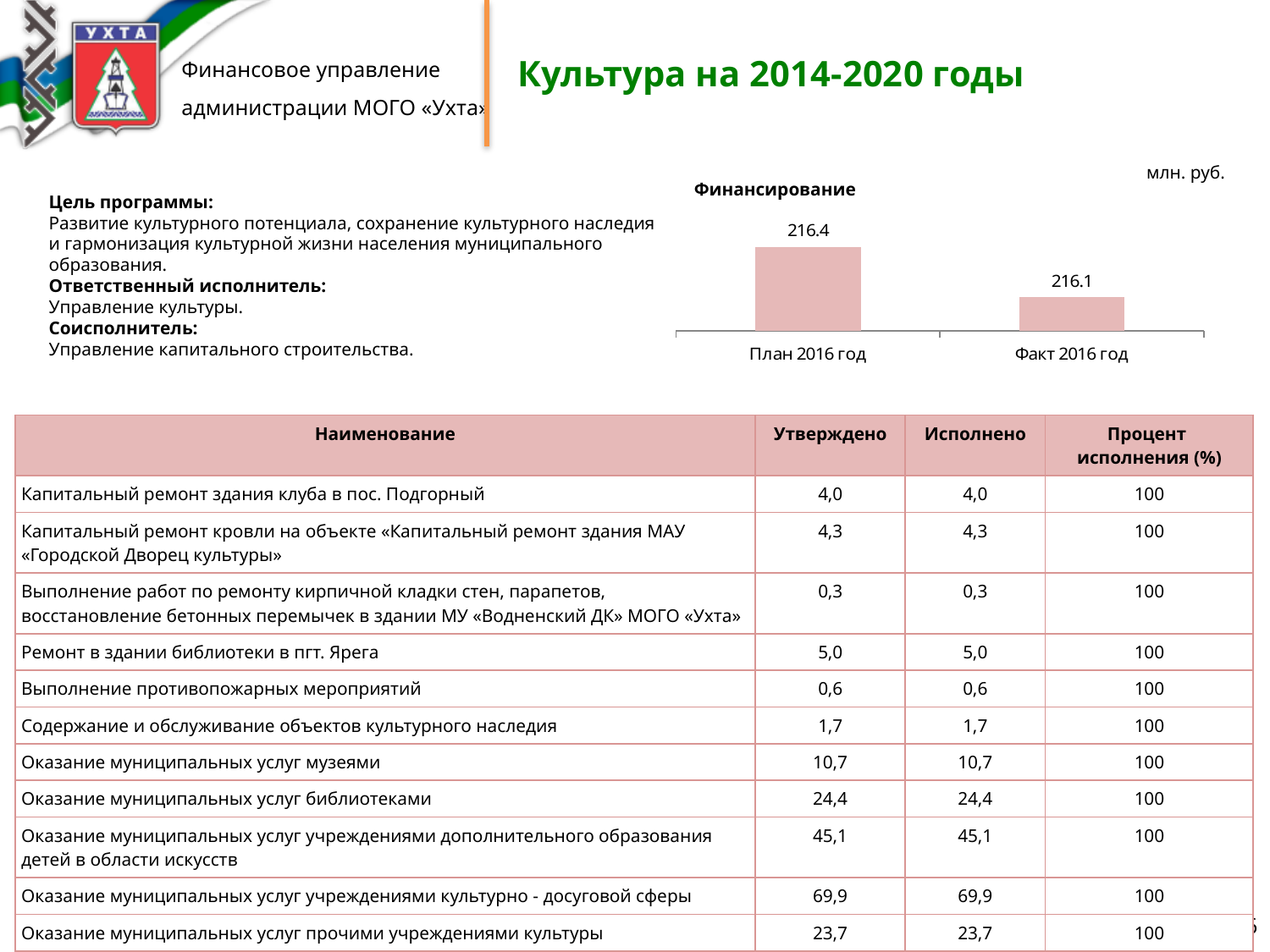
What is the value for Факт 2016 год in the Финансирование chart? 216.1 What is the value for План 2016 год in the Финансирование chart? 216.4 What type of chart is the Финансирование chart? bar chart Which category has the higher value in the Финансирование chart? План 2016 год What unit is indicated for the values in the Финансирование chart? млн. руб. What is the title of the chart on the slide? Финансирование Is the value for План 2016 год larger or smaller than the value for Факт 2016 год in the Финансирование chart? larger What is the difference between the План 2016 год and Факт 2016 год values in the Финансирование chart? 0.3 How many bars are shown in the Финансирование chart? 2 Do the values in the Финансирование chart rise or fall from План 2016 год to Факт 2016 год? fall Which category has the lower value in the Финансирование chart? Факт 2016 год